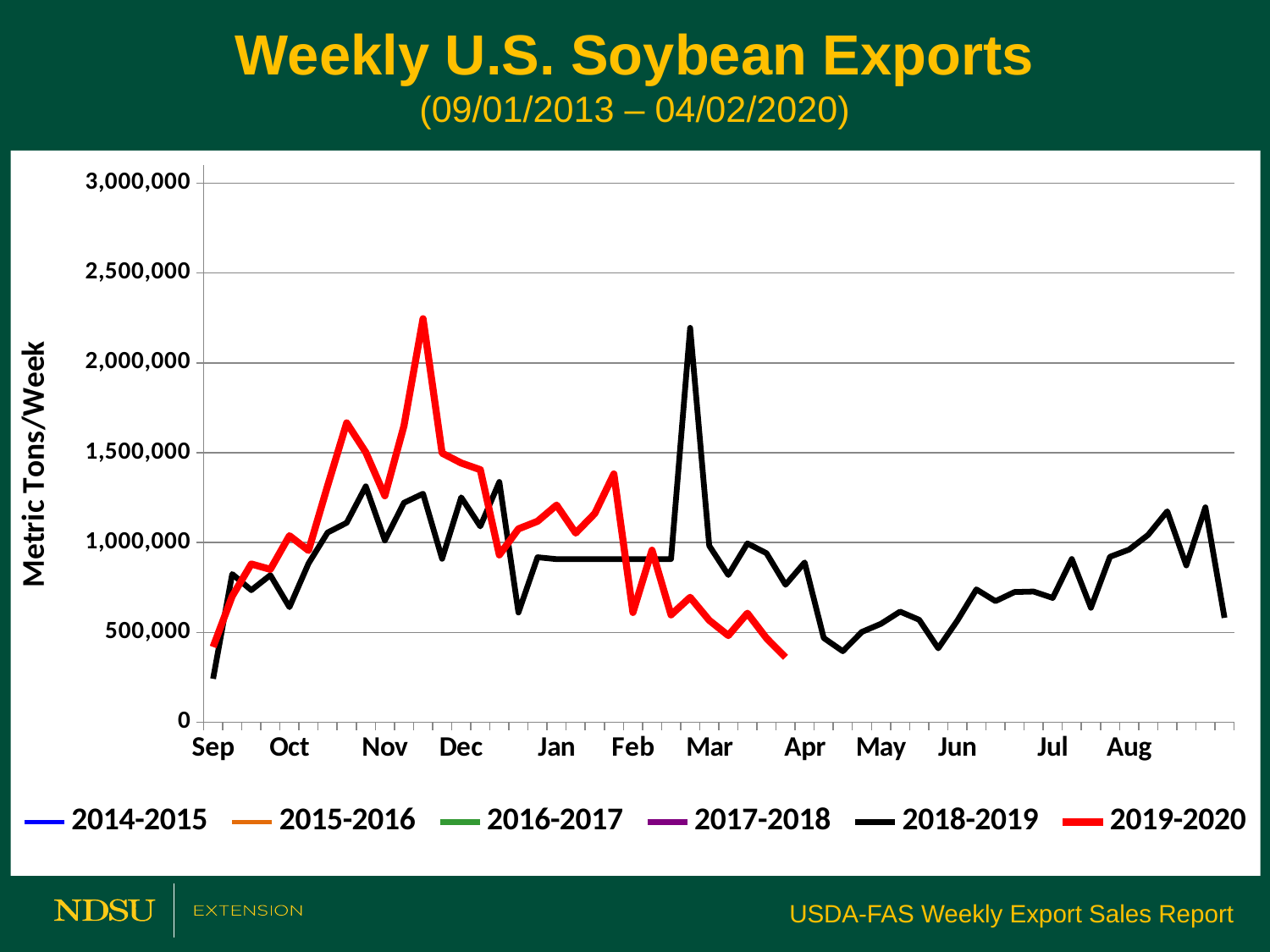
How many series does the legend list? 6 Is the last plotted value of the 2019-2020 series in late March greater or less than 500,000 metric tons/week? less In which month does the 2018-2019 series reach its lowest value? Sep Which series is drawn in red? 2019-2020 Does the 2019-2020 series generally rise or fall from early February to the end of March? fall Is the peak value of the 2019-2020 series greater or less than 2,000,000 metric tons/week? greater What kind of chart is shown on the slide? line chart Is the first value of the 2018-2019 series in September greater or less than 500,000 metric tons/week? less In which month does the 2019-2020 series reach its highest value? Nov How many months are labelled along the x axis? 12 In mid-November, which series is higher, 2018-2019 or 2019-2020? 2019-2020 What is the title of the chart? Weekly U.S. Soybean Exports